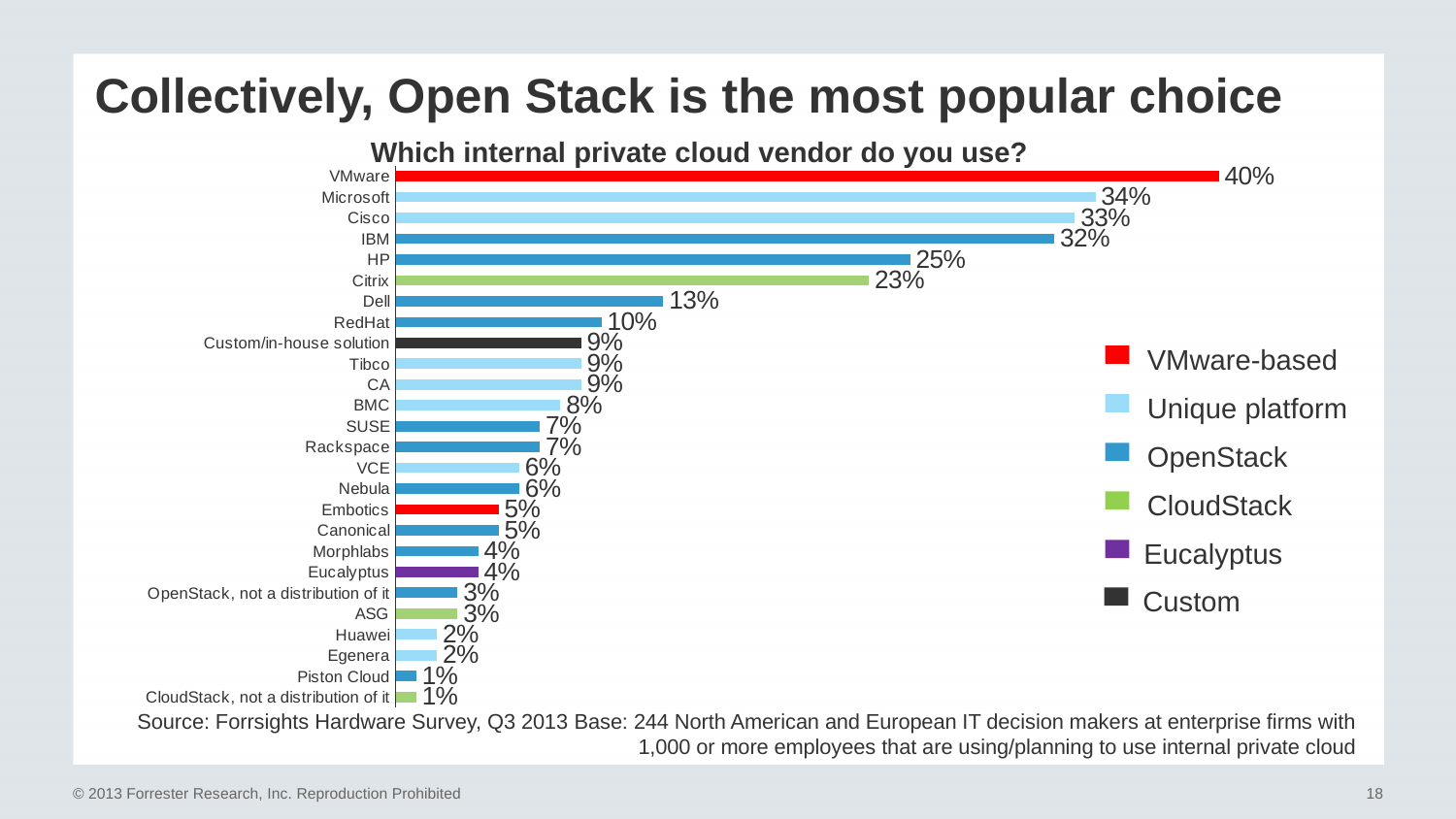
Which vendor has the highest percentage in the chart? VMware How many vendors/categories are listed in the chart? 26 How many entries does the legend list? 6 What is the difference between the values for VMware and Microsoft? 6% What is the value shown for Citrix? 23% Which has a larger value, Canonical or Morphlabs? Canonical Which legend entry is represented by the green colour? CloudStack What is the difference between the values for HP and RedHat? 15% What is the value shown for Dell? 13% What type of chart is shown on the slide? Bar chart Which has a larger value, IBM or HP? IBM What percentage of respondents use VMware as their internal private cloud vendor? 40%